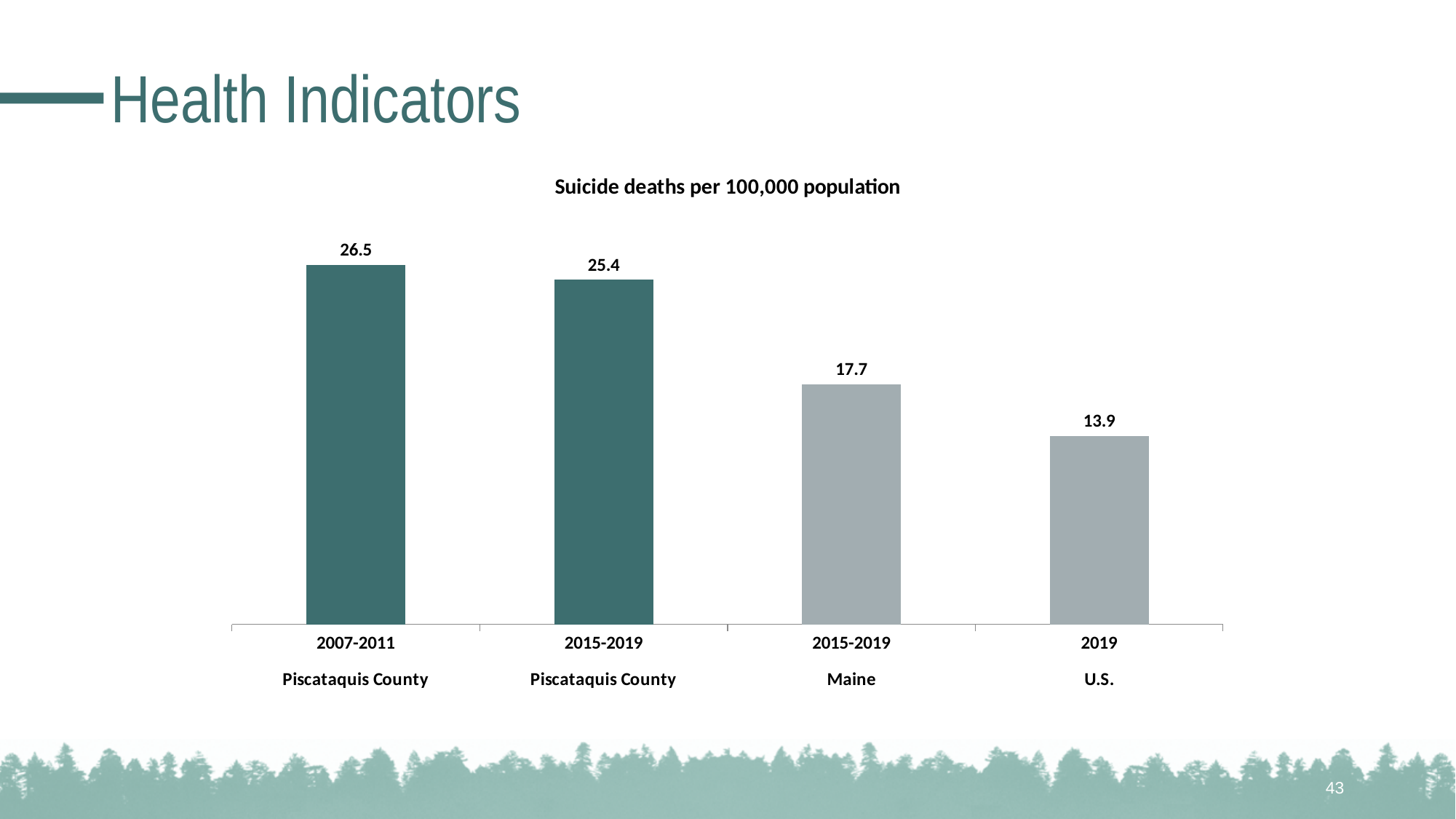
What kind of chart is shown on the slide? Bar chart What is the value for Maine in 2015-2019? 17.7 What is the value for Piscataquis County in 2007-2011? 26.5 Which category has the highest value? Piscataquis County 2007-2011 Which is larger, the value for Maine 2015-2019 or the value for U.S. 2019? Maine 2015-2019 Which category has the lowest value? U.S. 2019 What is the difference between Piscataquis County 2007-2011 and Piscataquis County 2015-2019? 1.1 What is the difference between Piscataquis County 2015-2019 and Maine 2015-2019? 7.7 How many bars are shown in the chart? 4 What is the value for Piscataquis County in 2015-2019? 25.4 What is the value for the U.S. in 2019? 13.9 What is the title of the chart? Suicide deaths per 100,000 population